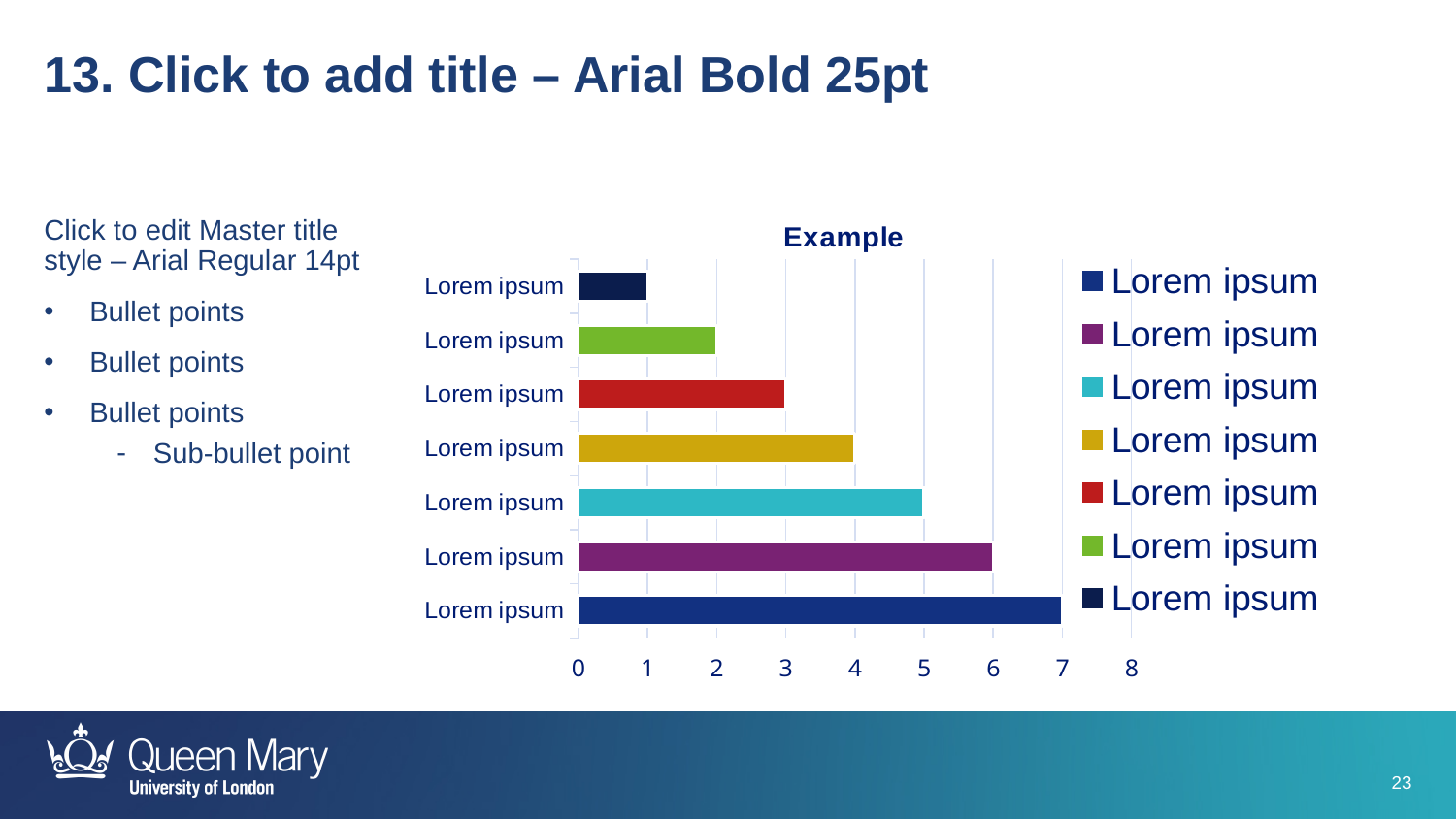
What is the difference between the purple bar's value and the green bar's value? 4 What value does the longest (bottom, dark blue) bar reach on the axis? 7 Which bar is longer, the gold bar or the red bar? the gold bar How many bars are plotted in the chart? 7 What kind of chart is shown on the slide? bar chart Is the value of the purple bar greater or less than 4? greater What value does the red bar reach on the axis? 3 How many entries does the chart's legend list? 7 What value does the shortest (top, navy) bar reach on the axis? 1 What value does the cyan (light blue) bar reach on the axis? 5 What is the title of the chart? Example Do the bar values increase or decrease going from the top bar to the bottom bar? increase